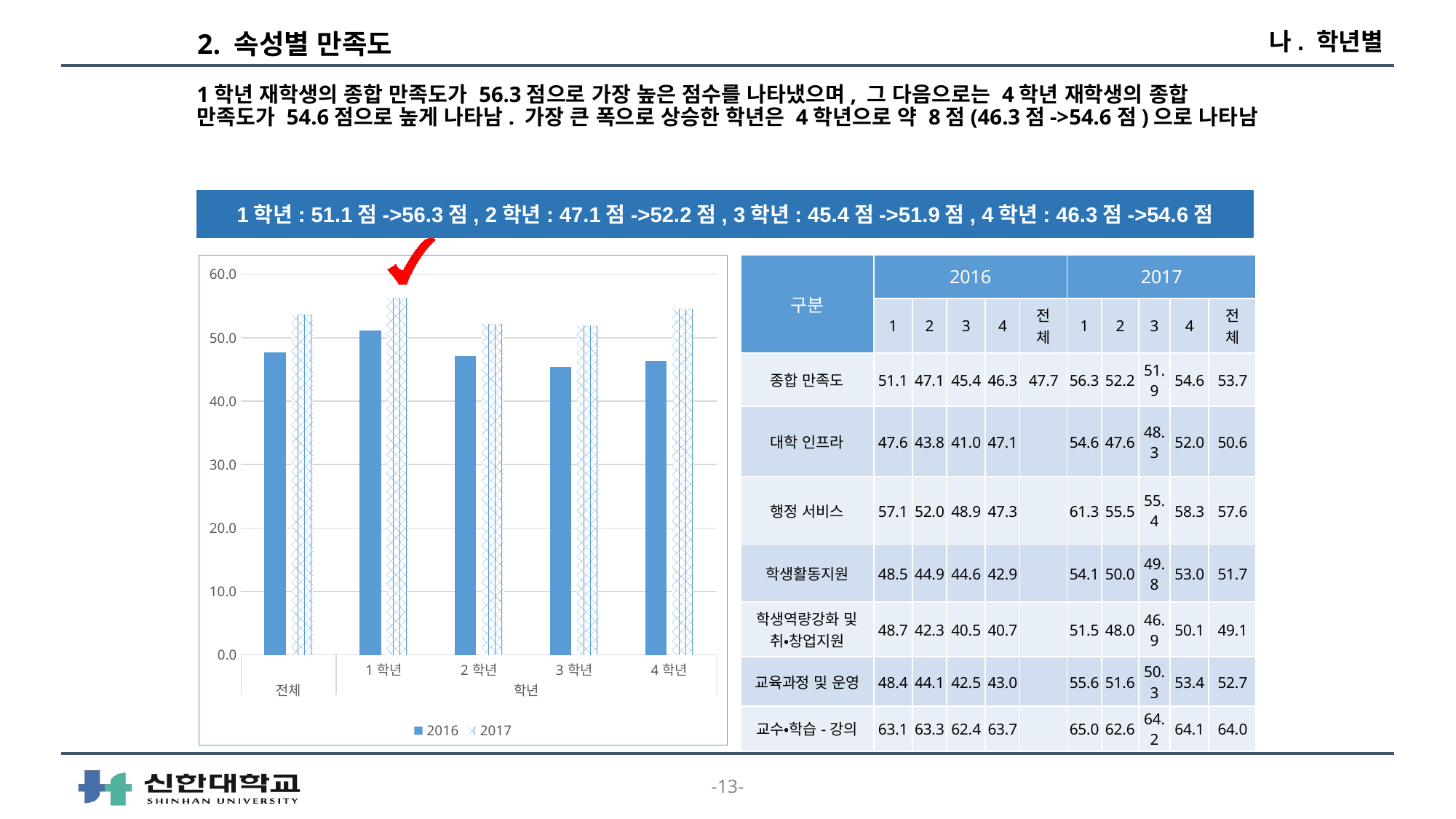
Which category has the lowest 2016 value in the chart? 3 학년 What type of chart is shown on the slide? bar chart What is the 2016 value for 4 학년? 46.3 Is the 2017 value for 4 학년 greater or less than 50.0? greater What is the difference between the 2017 and 2016 values for 4 학년? 8.3 Which category has the highest 2017 value in the chart? 1 학년 What is the 2017 value for 1 학년? 56.3 What are the two entries in the chart legend? 2016 and 2017 How many series does the chart legend list? 2 For 전체, which series has the larger value, 2016 or 2017? 2017 Is the 2016 value for 3 학년 greater or less than 50.0? less How many categories are shown on the x axis of the chart? 5